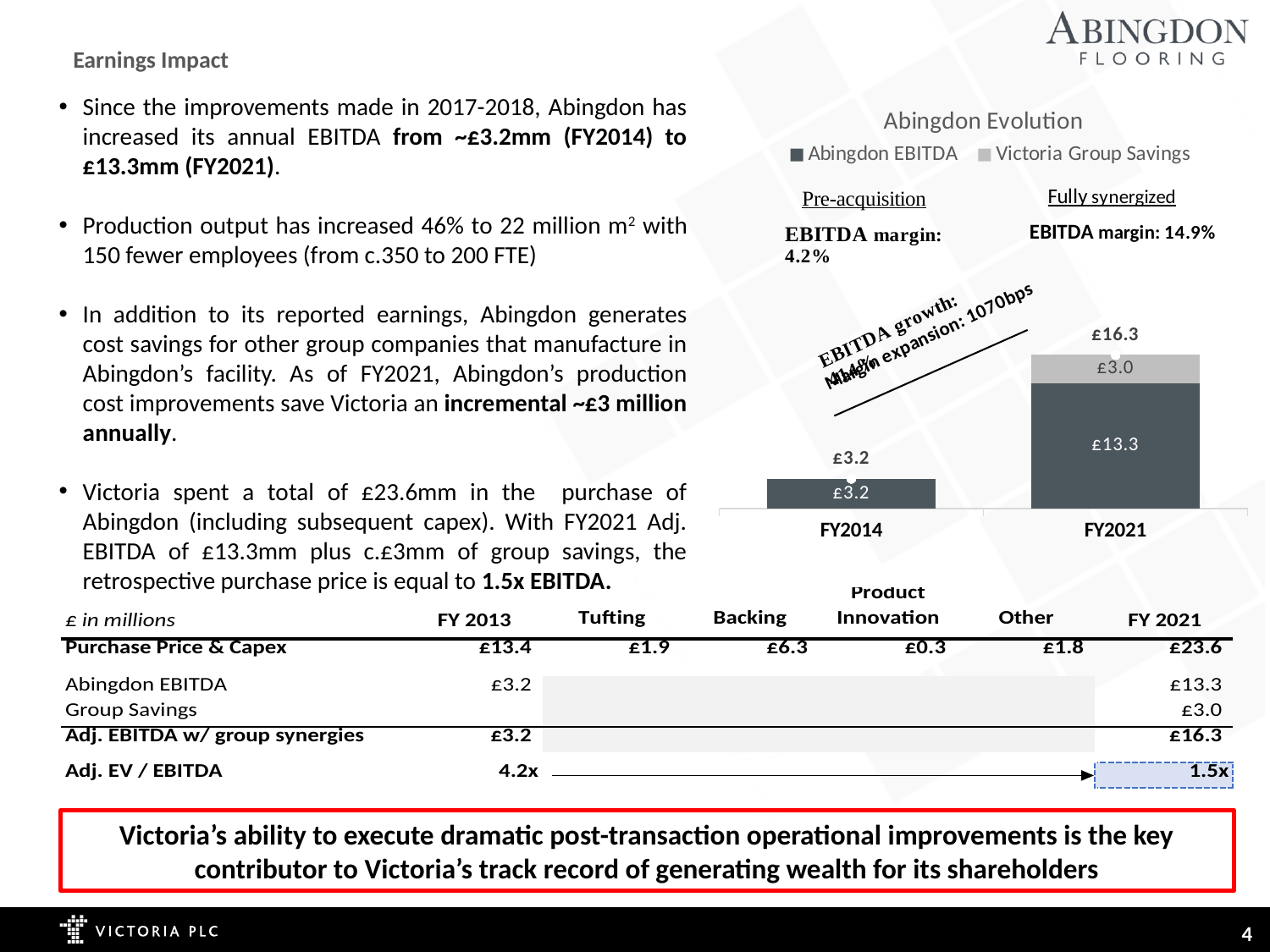
Which category has the higher Abingdon EBITDA in the Abingdon Evolution chart, FY2014 or FY2021? FY2021 What type of chart is the Abingdon Evolution chart? Stacked bar chart How many series does the legend of the Abingdon Evolution chart list? 2 What is the Abingdon EBITDA value for FY2021 in the Abingdon Evolution chart? £13.3 What is the Abingdon EBITDA value for FY2014 in the Abingdon Evolution chart? £3.2 What is the title of the chart on the slide? Abingdon Evolution Does the Abingdon EBITDA rise or fall from FY2014 to FY2021 in the Abingdon Evolution chart? Rise Which series in the Abingdon Evolution chart is shown in the lighter grey colour? Victoria Group Savings What is the Victoria Group Savings value for FY2021 in the Abingdon Evolution chart? £3.0 What is the total of the stacked bar for FY2021 in the Abingdon Evolution chart? £16.3 What is the difference between the Abingdon EBITDA for FY2021 and FY2014 in the Abingdon Evolution chart? £10.1 How many categories are shown on the x axis of the Abingdon Evolution chart? 2